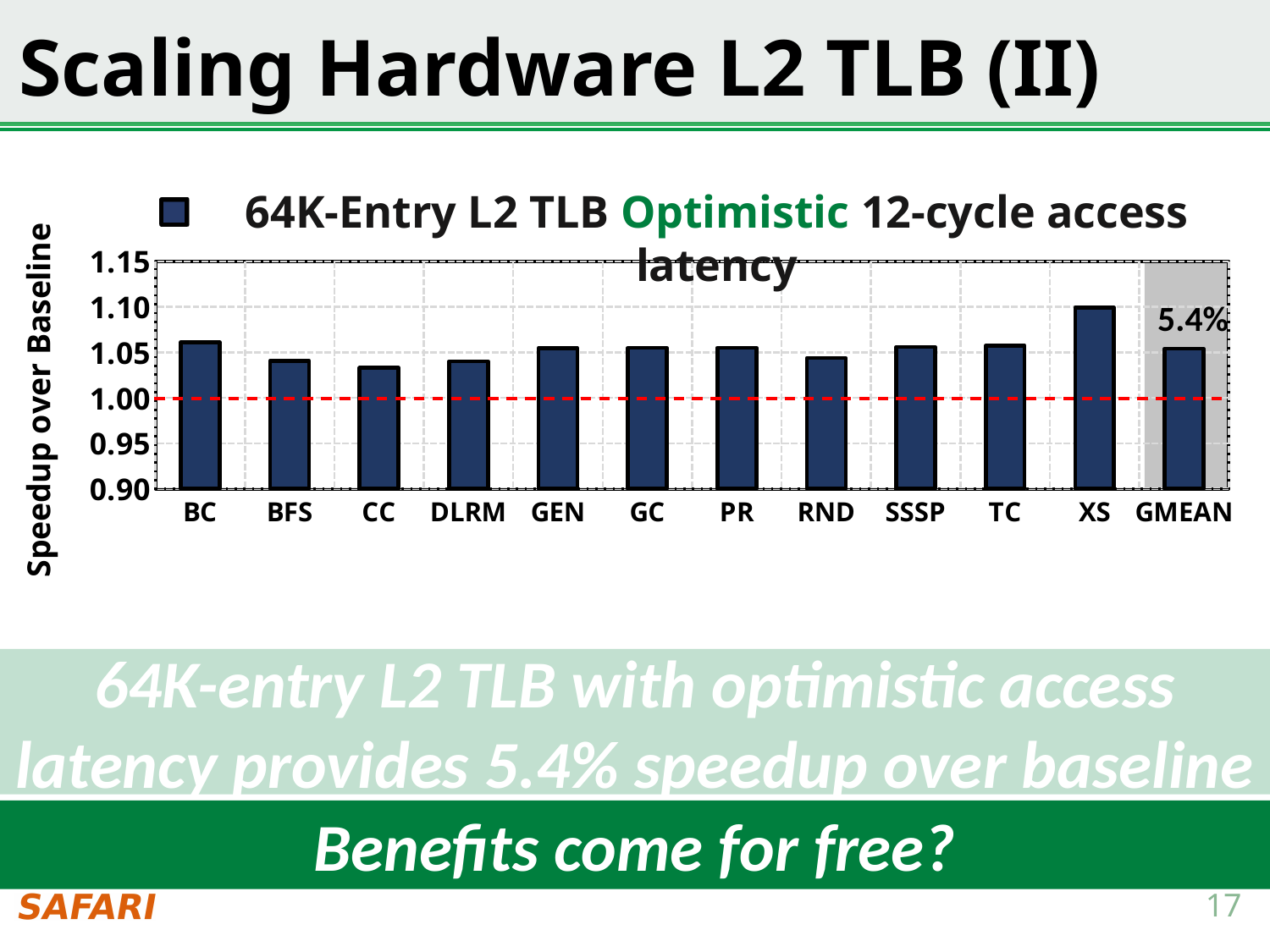
Is the speedup for CC greater or less than 1.05? less What type of chart is shown on the slide? bar chart How many categories are shown on the x axis of the chart? 12 At what y-axis value is the red dashed horizontal line drawn? 1.00 What is the title of the y axis of the chart? Speedup over Baseline Is the speedup for XS greater or less than 1.05? greater How many series does the chart's legend list? 1 What value is labelled on the GMEAN bar? 5.4% Which has a larger speedup, XS or CC? XS Which has a larger speedup, BC or BFS? BC Which category has the highest speedup over baseline? XS Is the speedup for BC greater or less than 1.00? greater